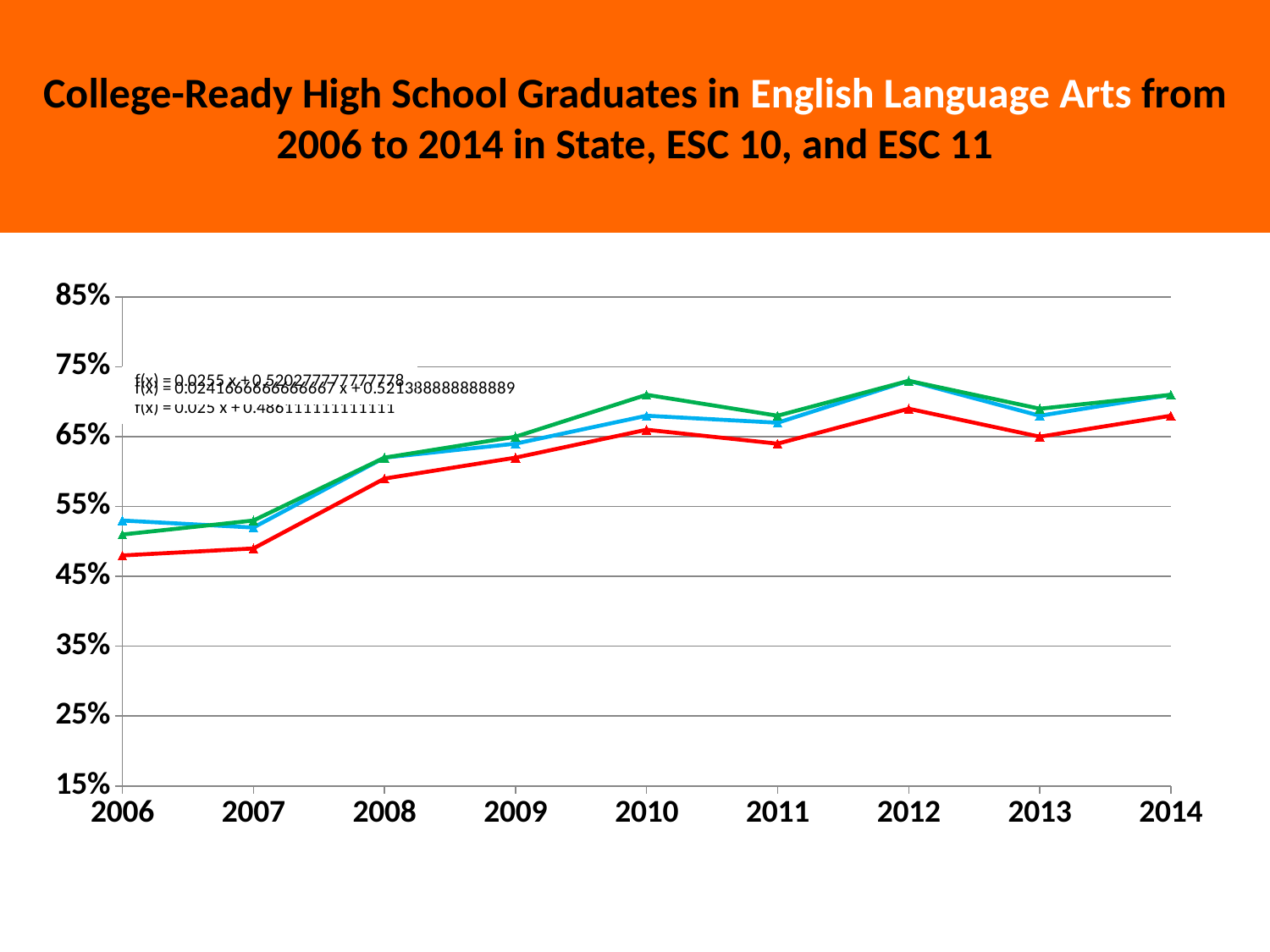
Is the value of the red line in 2006 greater or less than 55%? less Is the value of the green line in 2010 greater or less than 65%? greater How many lines are plotted on the chart? 3 What kind of chart is shown on the slide? line chart In 2010, which line has the higher value, the red line or the green line? green line For the red line, which year has the higher value, 2011 or 2012? 2012 Overall, do the values of the red line rise or fall from 2006 to 2014? rise Is the value of the red line in 2008 greater or less than 55%? greater How many years are shown along the x axis of the chart? 9 In which year does the green line reach its highest value? 2012 In which year does the green line have its lowest value? 2006